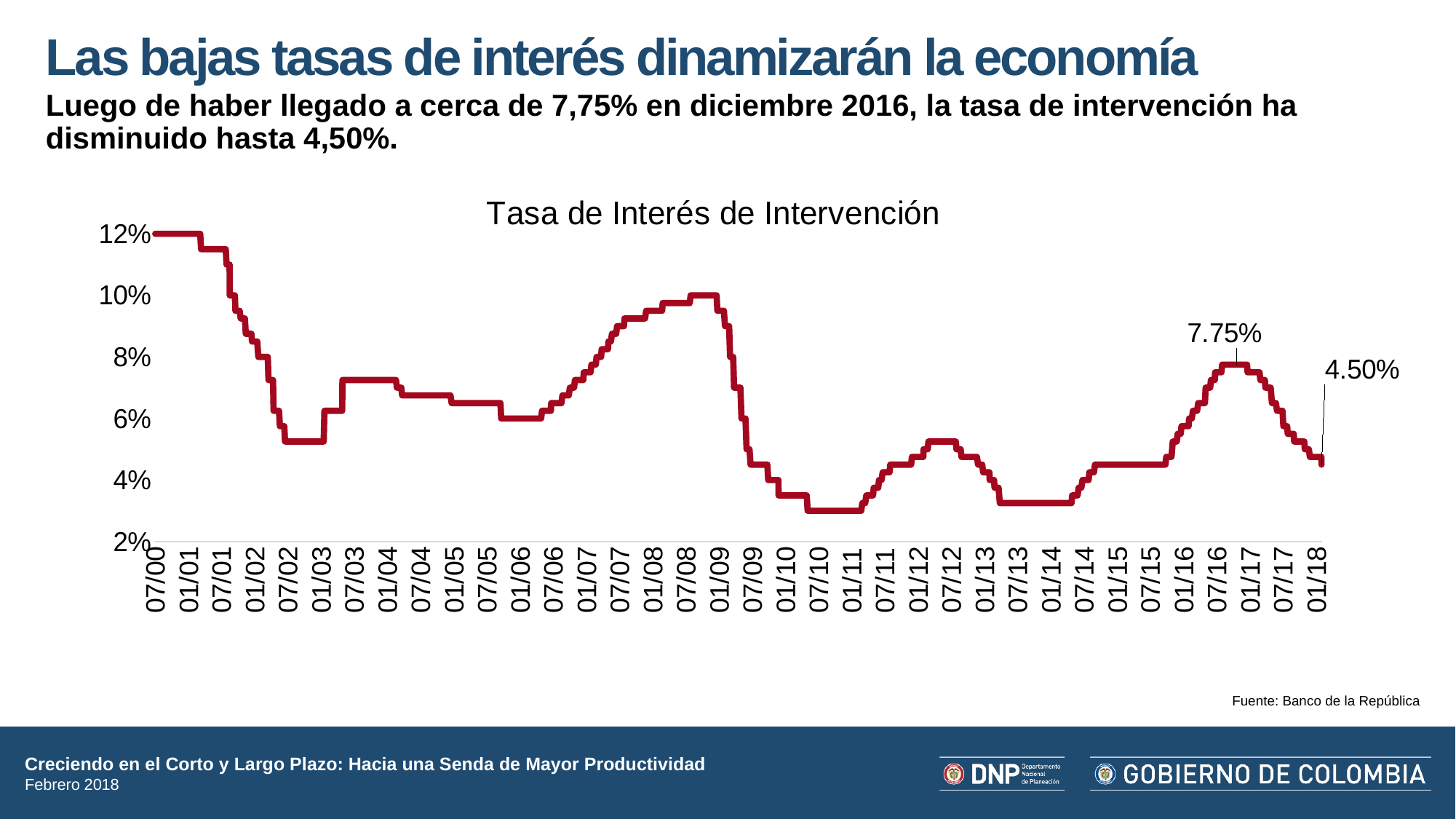
What is the value of the intervention interest rate at the last point of the line (01/18)? 4.50% Is the value at 07/08 greater or less than 8%? greater Which is larger, the value at 07/00 or the value at 01/18? 07/00 Is the value at 07/00 greater or less than 10%? greater Between 01/17 and 01/18, does the line rise or fall? fall Is the value at 07/10 greater or less than 4%? less Which is larger, the value at 07/08 or the value at 07/10? 07/08 What value is labelled at the peak of the line near 01/17? 7.75% What is the difference between the labelled peak value of 7.75% and the final value of 4.50%? 3.25 percentage points What kind of chart is shown on the slide? line chart What is the title of the chart? Tasa de Interés de Intervención At which x-axis date does the line reach its highest value? 07/00